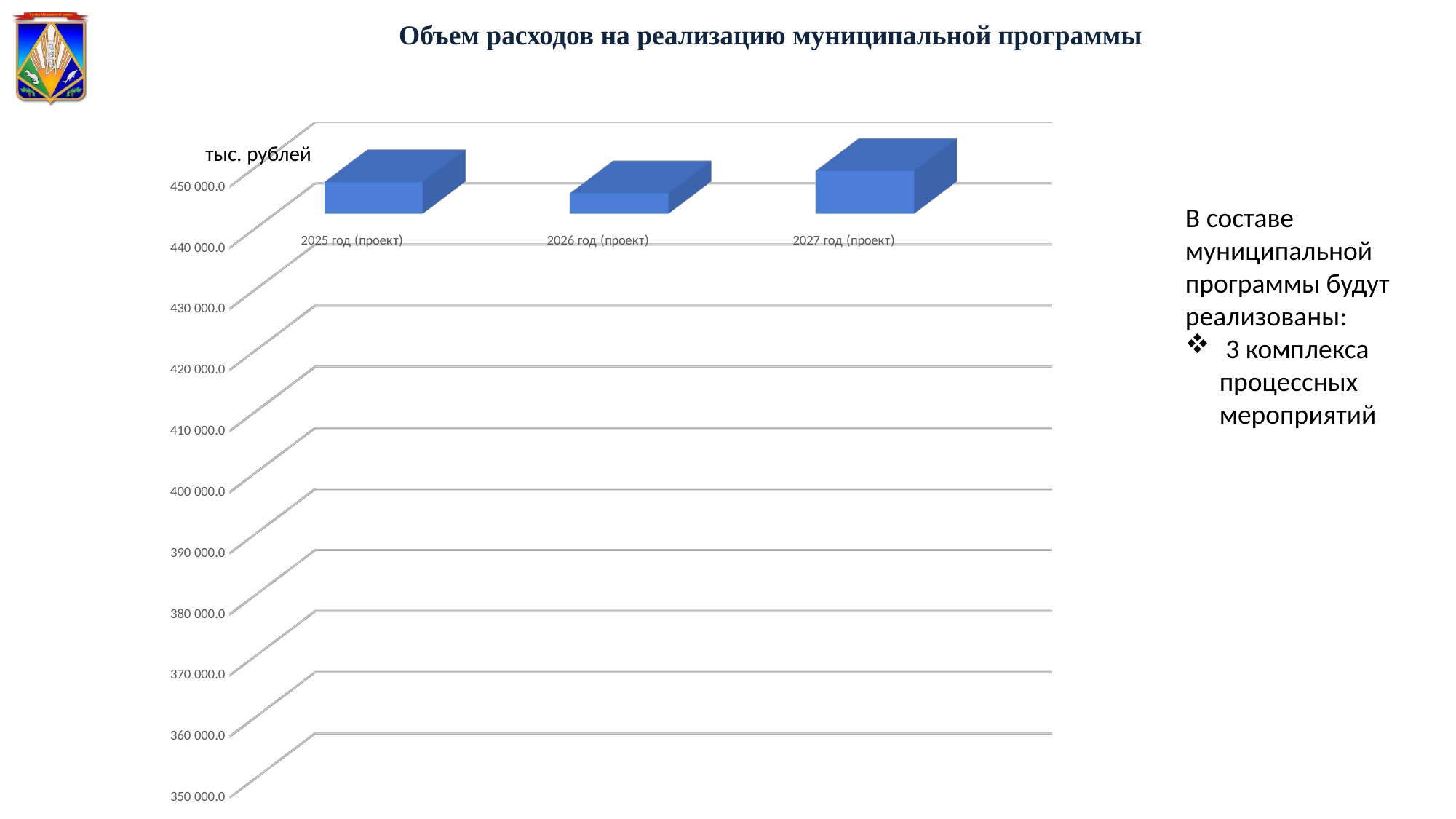
What kind of chart is shown on the slide? bar chart What is the highest tick value shown on the vertical axis? 450 000.0 Which year has the highest expenditure on the chart? 2027 год (проект) What unit is indicated for the values on the chart? тыс. рублей Is the value for 2026 год (проект) greater or less than 400 000.0? greater What is the lowest tick value shown on the vertical axis? 350 000.0 What is the title of the chart on the slide? Объем расходов на реализацию муниципальной программы How many categories (years) are plotted on the chart? 3 Which is larger, the value for 2025 год (проект) or for 2026 год (проект)? 2025 год (проект) Which year has the lowest expenditure on the chart? 2026 год (проект) Is the value for 2027 год (проект) greater or less than 400 000.0? greater Which is larger, the value for 2026 год (проект) or for 2027 год (проект)? 2027 год (проект)